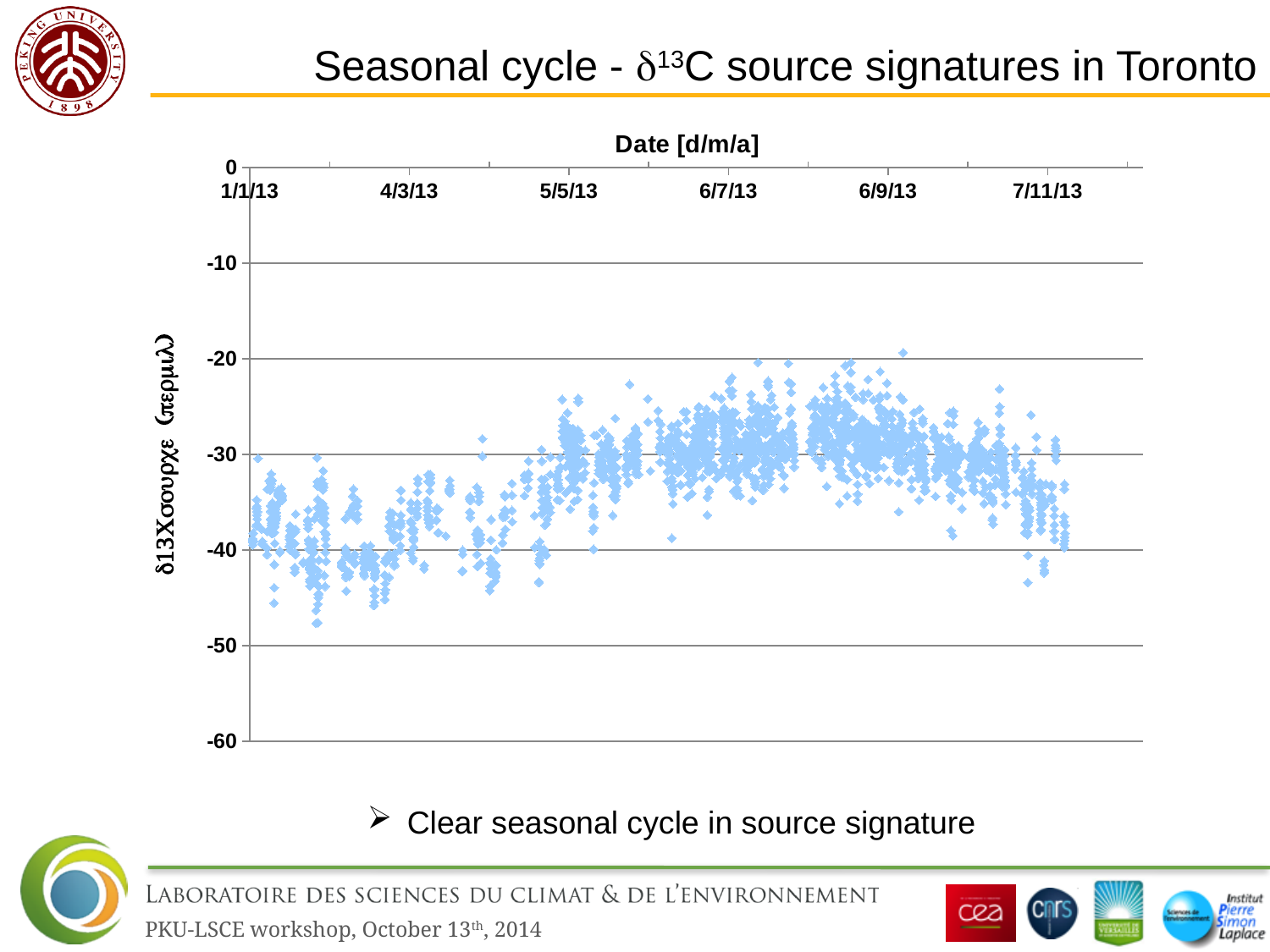
What is the first date label on the x axis of the chart? 1/1/13 Do the plotted values generally rise or fall from 1/1/13 to 6/7/13? rise Are the plotted values around 4/3/13 mostly greater or less than -30? less How many date labels are shown along the x axis of the chart? 6 What is the highest value shown on the y axis of the chart? 0 What is the lowest value shown on the y axis of the chart? -60 What is the title of the x axis of the chart? Date [d/m/a] Are the plotted values generally higher around 6/7/13 or around 1/1/13? 6/7/13 What kind of chart is shown on the slide? scatter chart What is the last date label on the x axis of the chart? 7/11/13 Are the plotted values around 1/1/13 mostly greater or less than -30? less Are the plotted values around 6/7/13 mostly greater or less than -40? greater